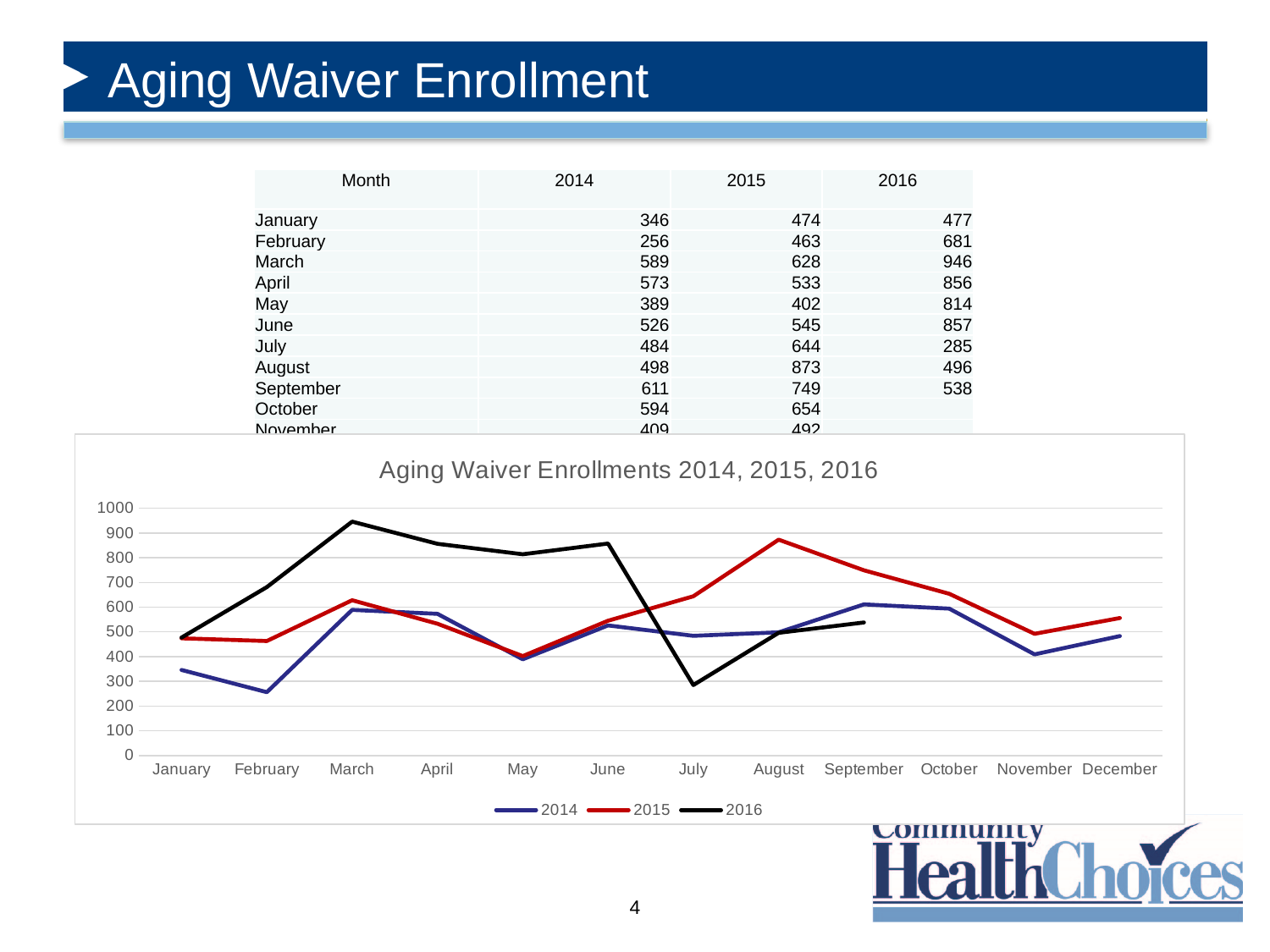
What is the Aging Waiver enrollment for September 2015? 749 Does the 2016 line rise or fall from June to July? fall What kind of chart is shown on the slide? line chart What is the difference between the August 2015 and August 2014 enrollments? 375 What is the title of the chart? Aging Waiver Enrollments 2014, 2015, 2016 How many months are shown along the x axis of the chart? 12 Which is larger, the July 2015 enrollment or the July 2016 enrollment? July 2015 Which month has the lowest enrollment in the 2014 series? February What is the Aging Waiver enrollment for March 2016? 946 Which month has the highest enrollment in the 2016 series? March Is the value for April 2016 greater or less than 800? greater How many series does the legend of the chart list? 3